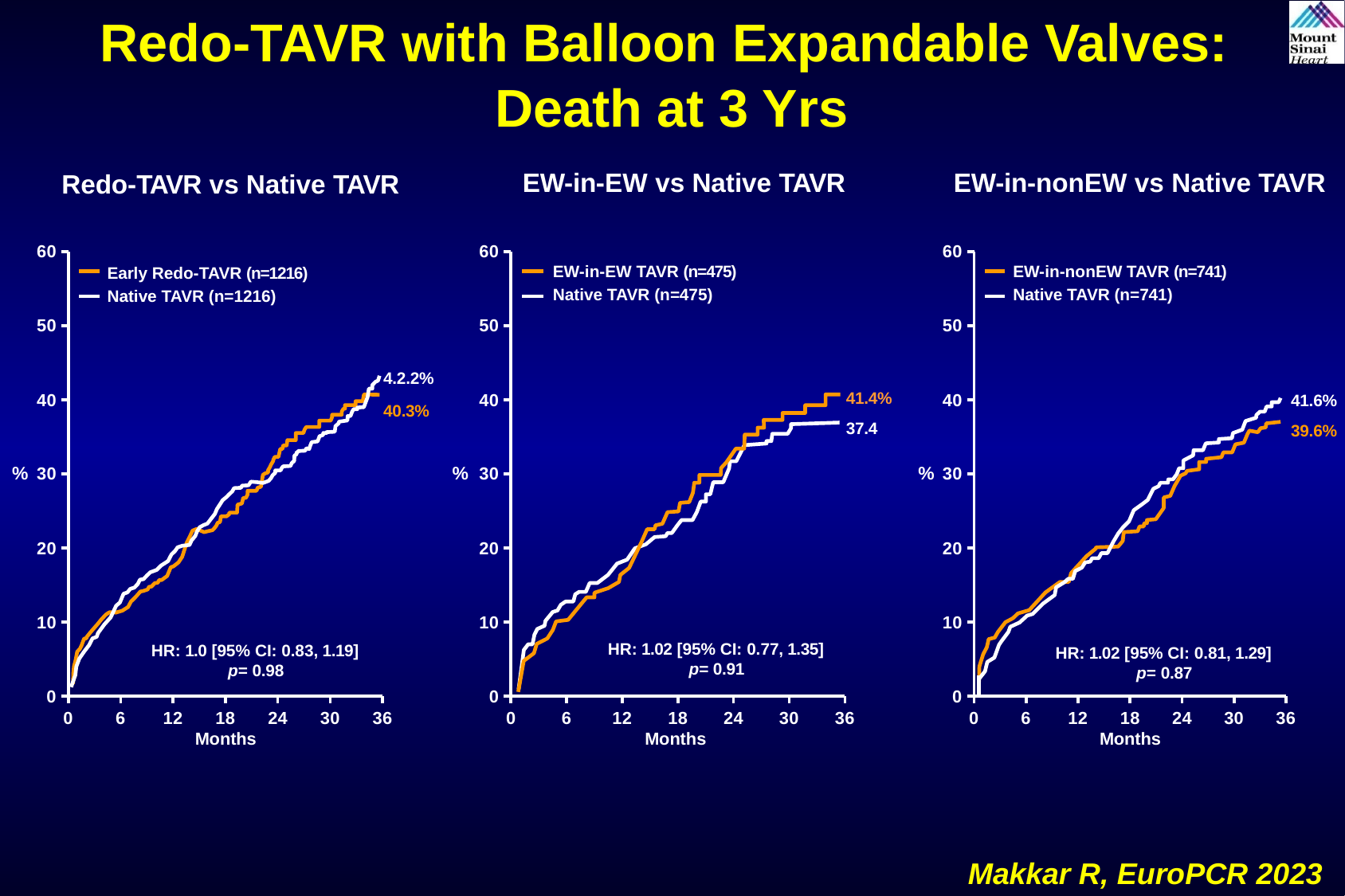
How many series does the legend of the 'EW-in-EW vs Native TAVR' chart list? 2 In the 'EW-in-EW vs Native TAVR' chart, what is the 3-year death rate labelled for EW-in-EW TAVR? 41.4% In the 'Redo-TAVR vs Native TAVR' chart, what is the final value labelled for Early Redo-TAVR? 40.3% In the 'EW-in-EW vs Native TAVR' chart, which curve ends higher at 36 months, EW-in-EW TAVR or Native TAVR? EW-in-EW TAVR In the 'EW-in-EW vs Native TAVR' chart, what value is labelled at the end of the Native TAVR curve? 37.4 In the 'EW-in-nonEW vs Native TAVR' chart, what is the final value labelled for Native TAVR? 41.6% What kind of chart is the 'Redo-TAVR vs Native TAVR' chart? Line chart In the 'EW-in-nonEW vs Native TAVR' chart, what is the final value labelled for EW-in-nonEW TAVR? 39.6% In the 'EW-in-nonEW vs Native TAVR' chart, do the curves rise or fall as months increase? Rise In the 'EW-in-nonEW vs Native TAVR' chart, is the final value for EW-in-nonEW TAVR greater or less than 40? less In the 'EW-in-nonEW vs Native TAVR' chart, what is the difference between the final Native TAVR value and the final EW-in-nonEW TAVR value? 2.0% In the 'Redo-TAVR vs Native TAVR' chart, which curve ends higher, Early Redo-TAVR or Native TAVR? Native TAVR